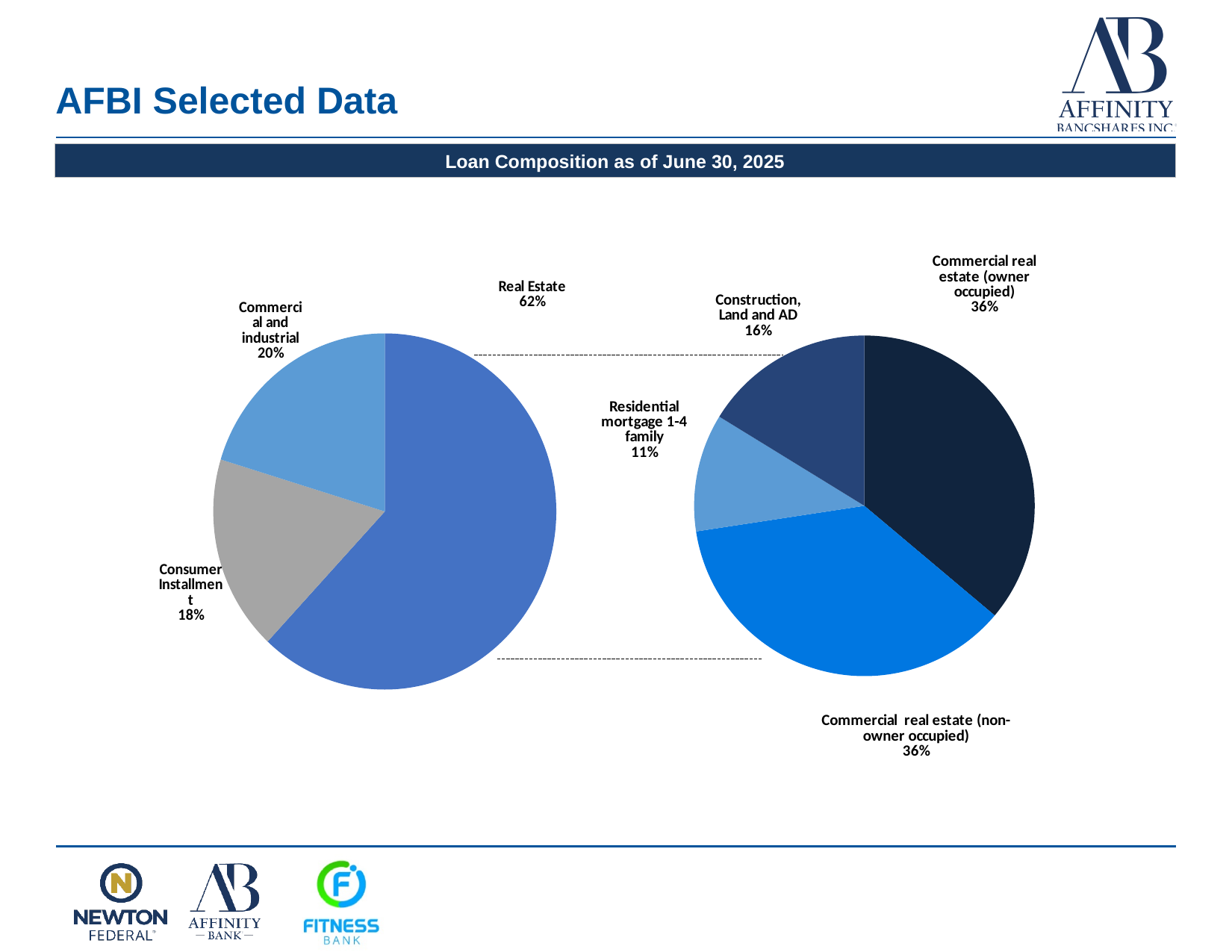
On the left pie chart, which category has the largest share? Real Estate On the left pie chart, what share of loans is Real Estate? 62% On the right pie chart, which category has the smallest share? Residential mortgage 1-4 family On the right pie chart, what share is Residential mortgage 1-4 family? 11% On the right pie chart, what share is Commercial real estate (owner occupied)? 36% What type of chart is used on this slide? Pie chart On the left pie chart, what share is Consumer Installment? 18% On the left pie chart, what is the difference in percentage points between Real Estate and Commercial and industrial? 42 On the left pie chart, what share is Commercial and industrial? 20% How many slices does the right pie chart have? 4 On the right pie chart, what share is Construction, Land and AD? 16% On the left pie chart, which category has the smallest share? Consumer Installment